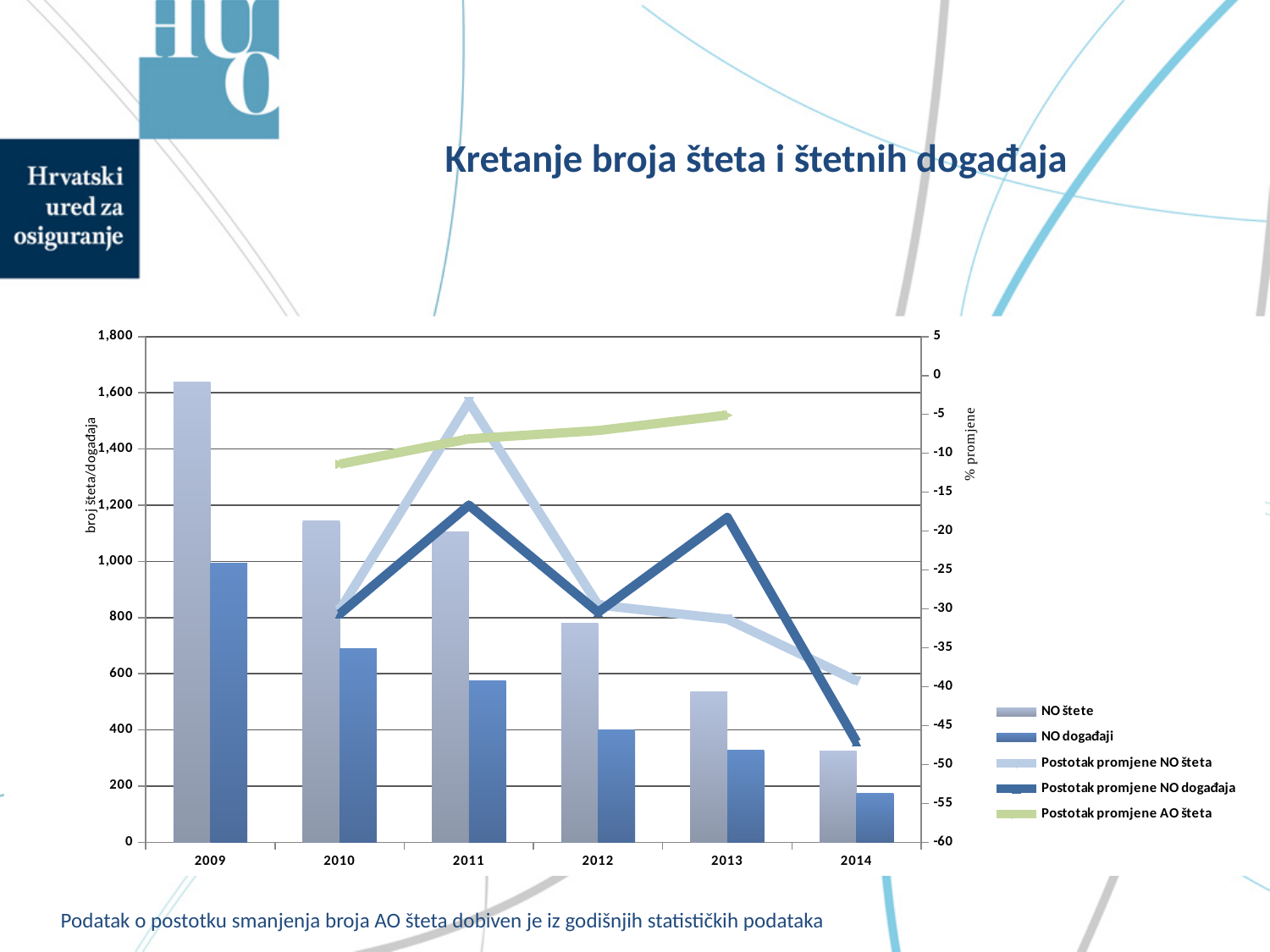
In which year is the NO štete bar lowest? 2014 Which is larger in 2012, NO štete or NO događaji? NO štete Is the NO događaji value for 2010 greater or less than 600? greater Is the NO štete value for 2013 greater or less than 600? less What kind of chart is shown on the slide? A combined bar and line chart What is the title of the chart? Kretanje broja šteta i štetnih događaja How many years are shown on the x axis? 6 Do the NO štete bars rise or fall from 2009 to 2014? Fall In which year is the NO štete bar highest? 2009 How many series does the legend list? 5 What is the label of the right-hand vertical axis? % promjene Is the NO štete value for 2009 greater or less than 1,600? greater